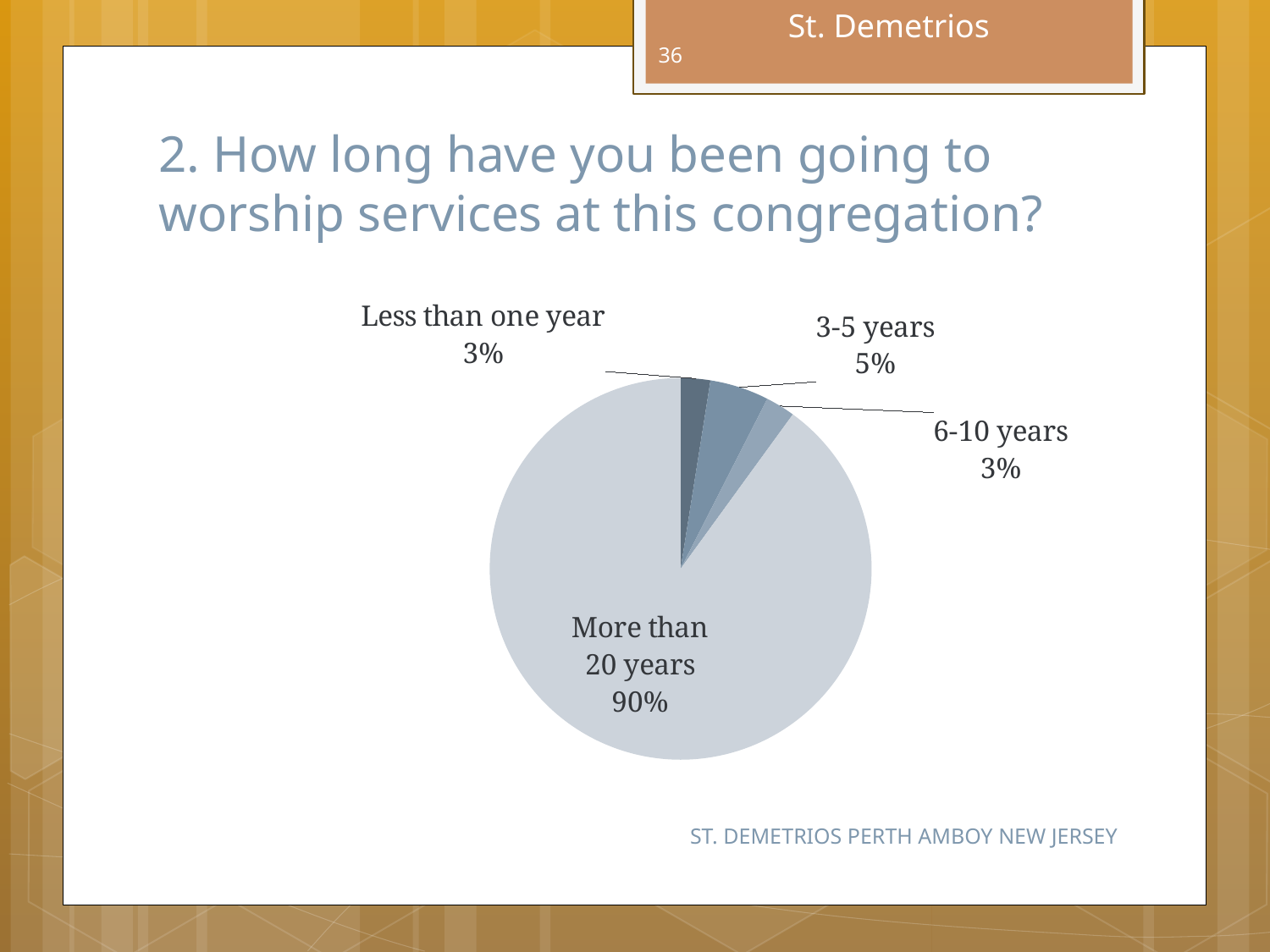
How many categories are shown in the pie chart? 4 What percentage of respondents answered less than one year? 3% Which congregation is named in the header of the slide? St. Demetrios What share of respondents have been going to worship services for more than 20 years? 90% What is the combined share of the 'Less than one year' and '6-10 years' slices? 6% What question does the chart on the slide answer? How long have you been going to worship services at this congregation? Which category has the largest share of the pie? More than 20 years Which is larger, the share for 3-5 years or the share for 6-10 years? 3-5 years What is the difference in percentage points between the 'More than 20 years' slice and the '3-5 years' slice? 85 What kind of chart is shown on the slide? pie chart What percentage of respondents answered 6-10 years? 3% What percentage of respondents answered 3-5 years? 5%